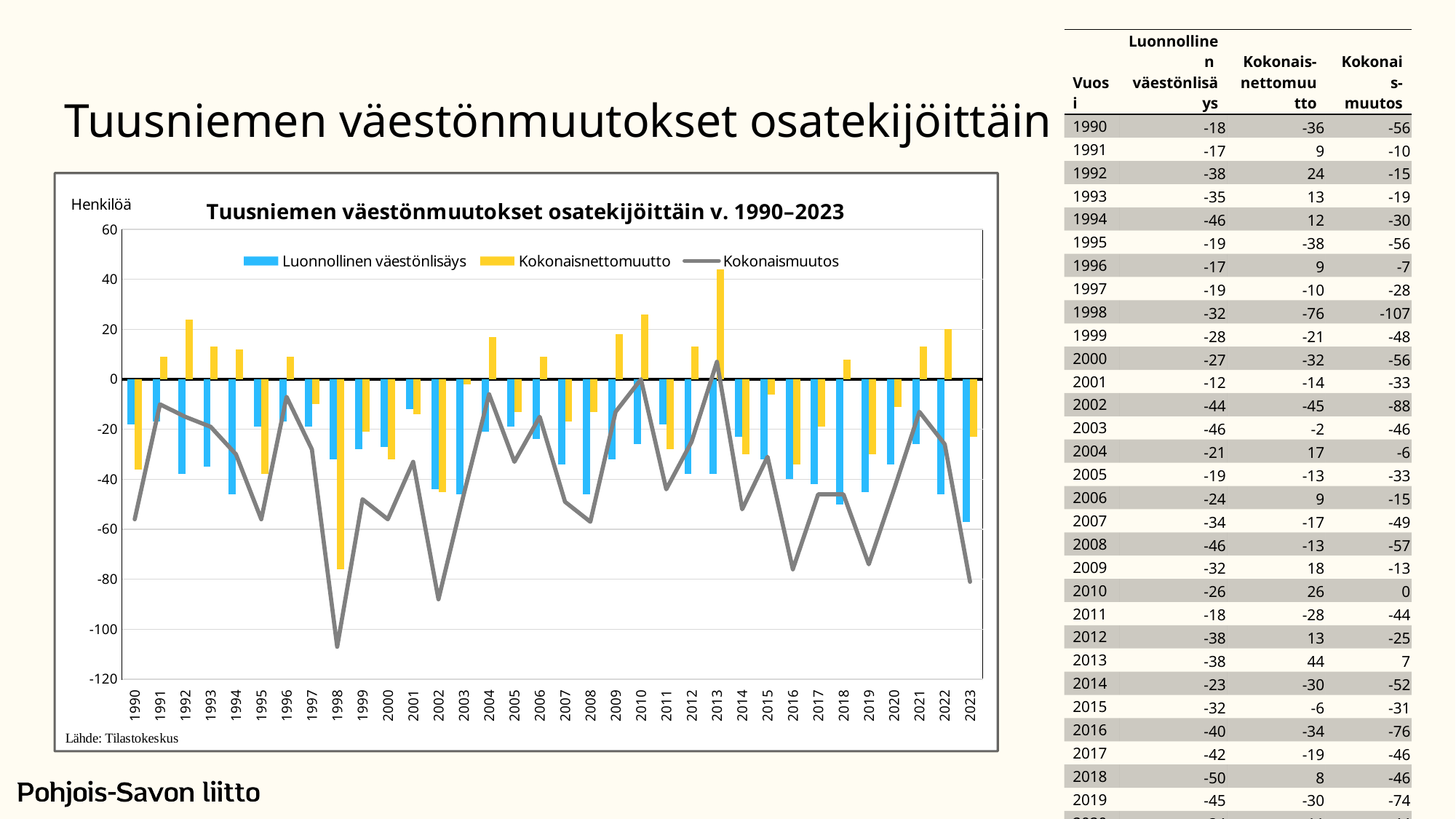
In which year is the Kokonaismuutos line at its lowest point? 1998 How many years are plotted along the x axis of the chart? 34 Is the value of Luonnollinen väestönlisäys for 2023 greater or less than -40? less What is the difference between Kokonaismuutos in 2013 and in 1998? 114 Which is larger, Kokonaisnettomuutto in 2010 or in 2013? 2013 How many series does the chart legend list? 3 What is the value of Kokonaismuutos for 1998? -107 What is the value of Luonnollinen väestönlisäys for 2018? -50 What colour are the Kokonaisnettomuutto bars in the chart? Yellow What kind of chart is shown on the slide? A bar chart combined with a line In which year is the Kokonaisnettomuutto bar the highest? 2013 What is the value of Kokonaismuutos for 2010? 0